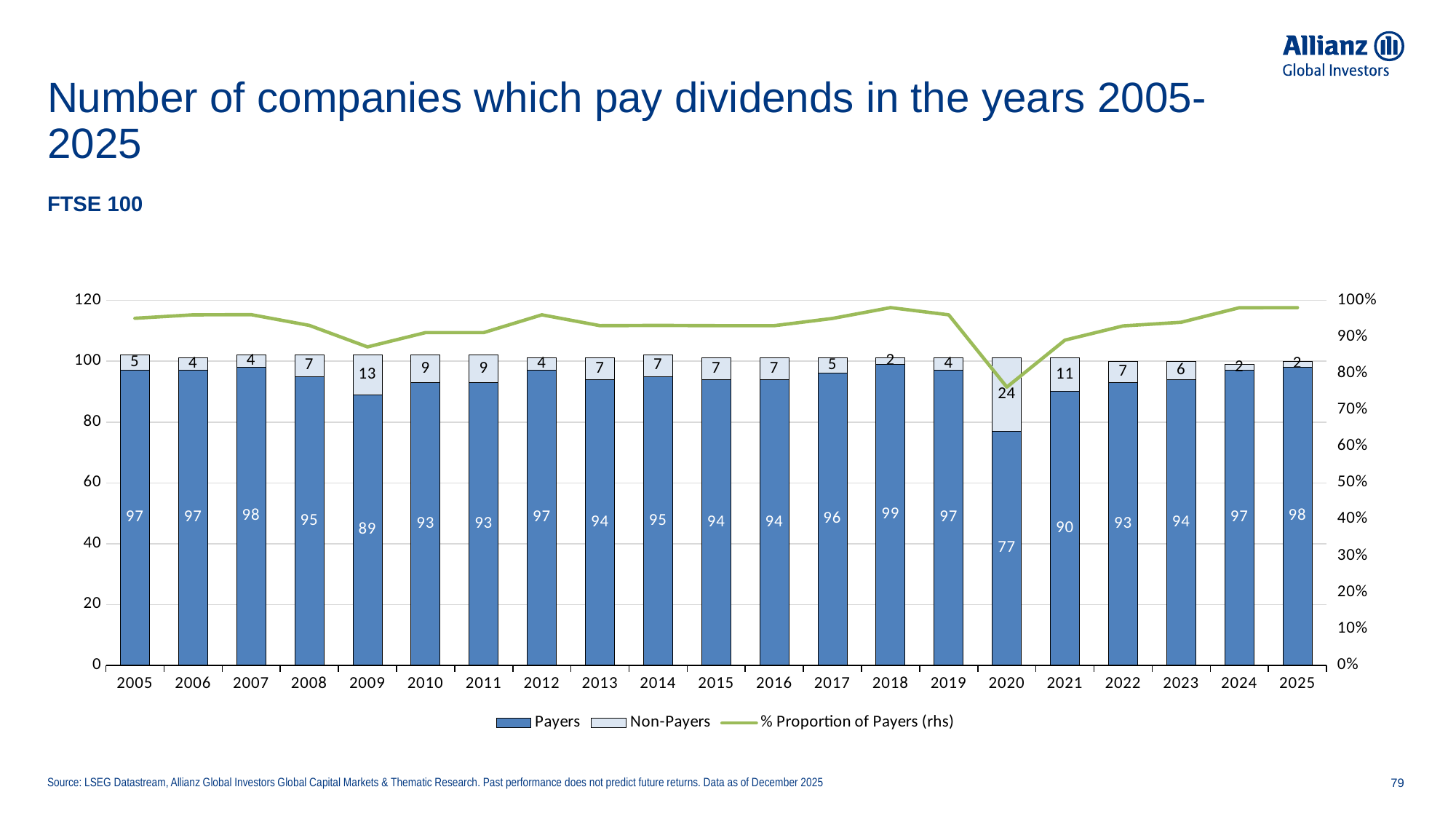
How many series does the legend list? 3 What is the total of the stacked bar for 2020 (Payers plus Non-Payers)? 101 Which is larger, the Payers value for 2009 or for 2021? 2009 How many Payers were there in 2020? 77 Do the Payers values rise or fall from 2020 to 2025? rise Which year has the highest number of Payers? 2018 How many years are shown on the x axis? 21 What is the Non-Payers value for 2009? 13 Is the % Proportion of Payers (rhs) for 2020 greater or less than 80%? less What is the difference between the Payers values for 2019 and 2020? 20 Which year has the lowest number of Payers? 2020 Which year has the highest Non-Payers value? 2020